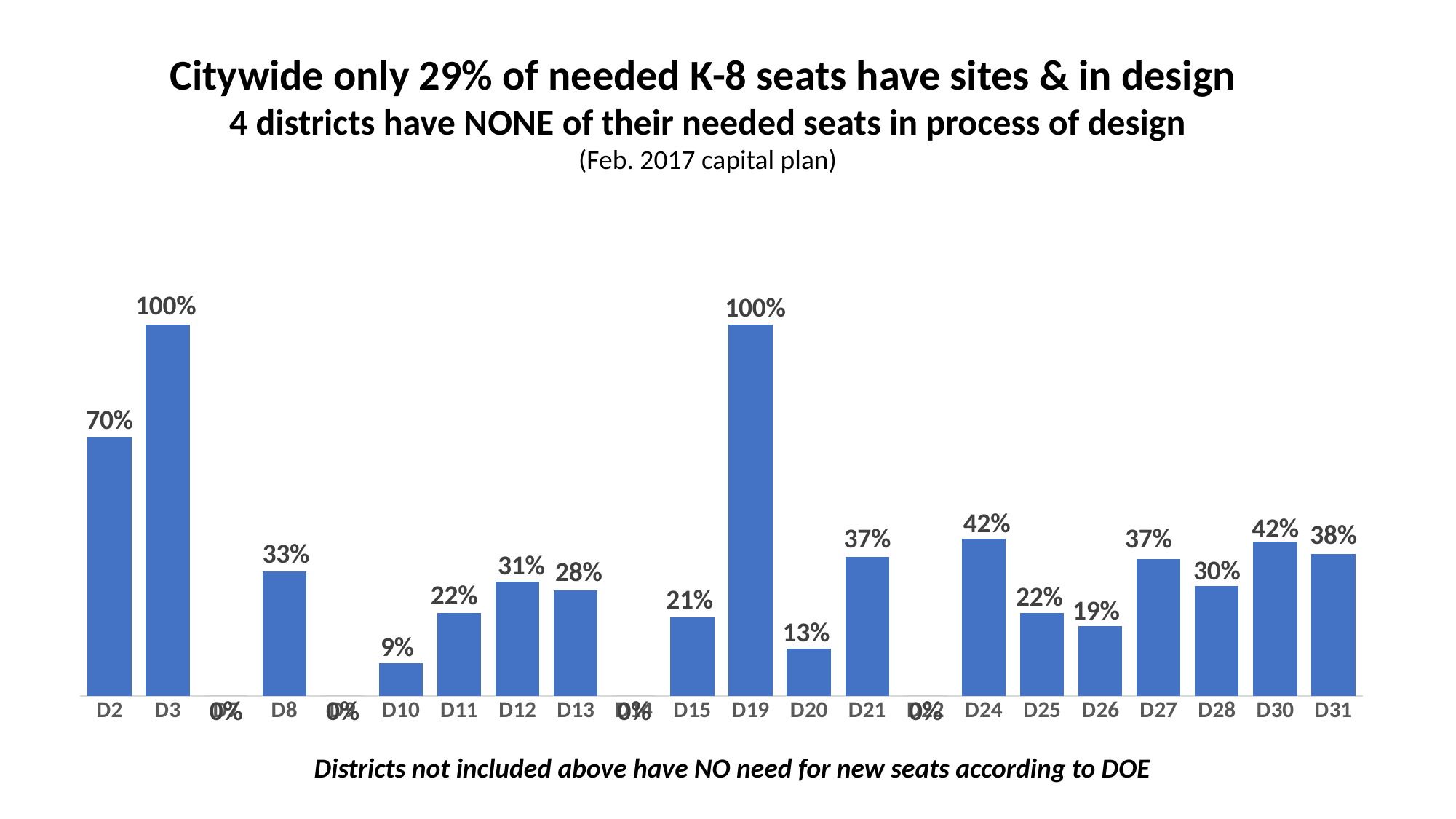
What is the value for D2? 70% According to the chart title, what percentage of needed K-8 seats citywide have sites and are in design? 29% Which is larger, the value for D12 or the value for D13? D12 How many districts show a value of 0%? 4 What is the value for D10? 9% What kind of chart is shown on the slide? Bar chart What is the difference between the values for D2 and D8? 37 percentage points What is the value for D31? 38% What is the difference between the values for D24 and D25? 20 percentage points Which district has the lowest nonzero value? D10 What is the highest value shown on the chart? 100% What is the value for D21? 37%